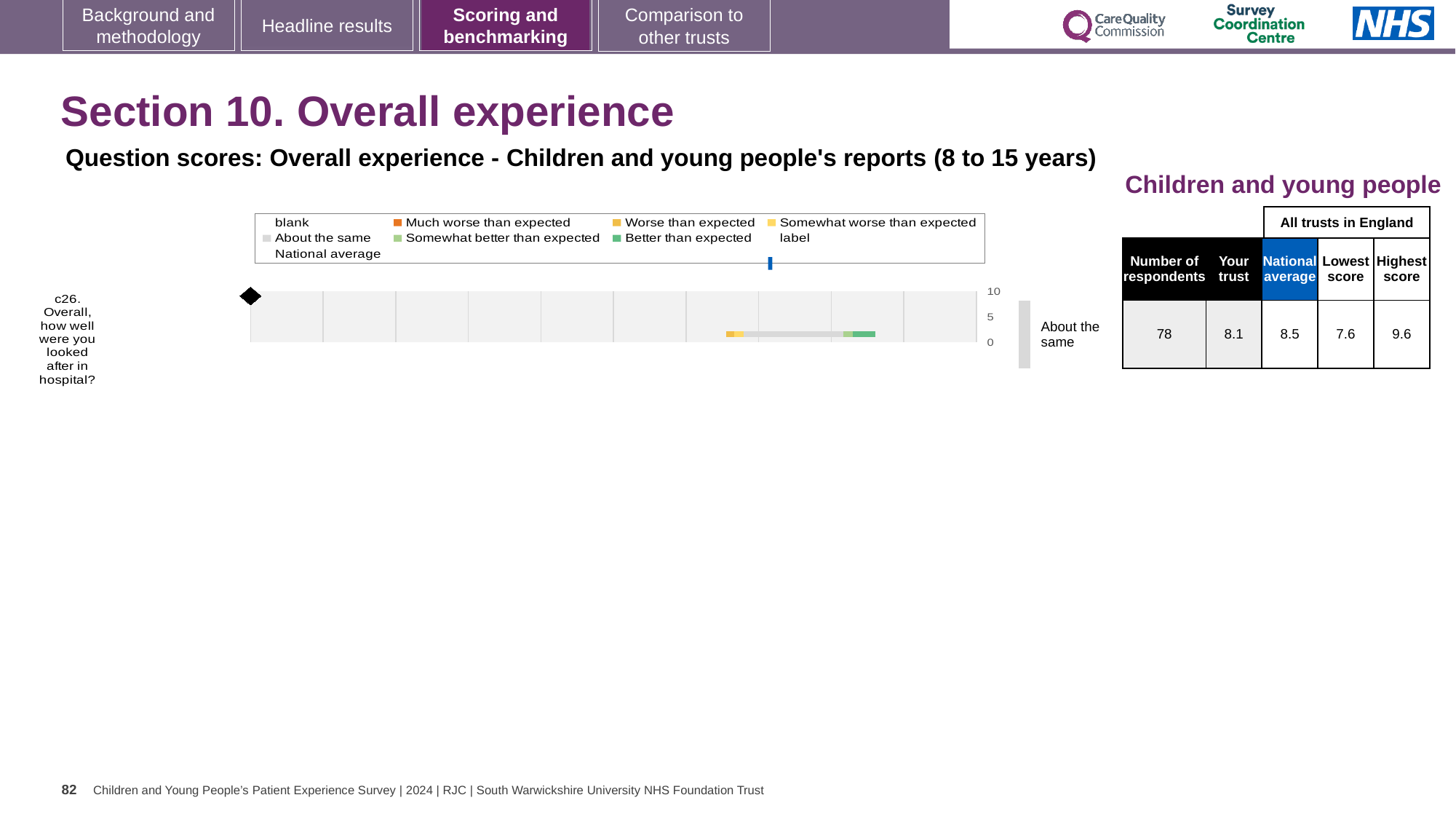
What is the lowest score among all trusts in England for question c26? 7.6 What is the difference between the highest and lowest scores for question c26 across all trusts in England? 2.0 What is the highest score among all trusts in England for question c26? 9.6 Is the trust's score for question c26 higher or lower than the national average? lower What is the trust's score for question c26 'Overall, how well were you looked after in hospital?'? 8.1 What is the national average score for question c26? 8.5 How many respondents answered question c26? 78 How many questions are plotted on the chart? 1 What is the difference between the national average and the trust's score for question c26? 0.4 How is the trust's result for question c26 categorised relative to expectations? About the same What is the maximum value shown on the chart's score axis? 10 What kind of chart is shown on the slide? bar chart